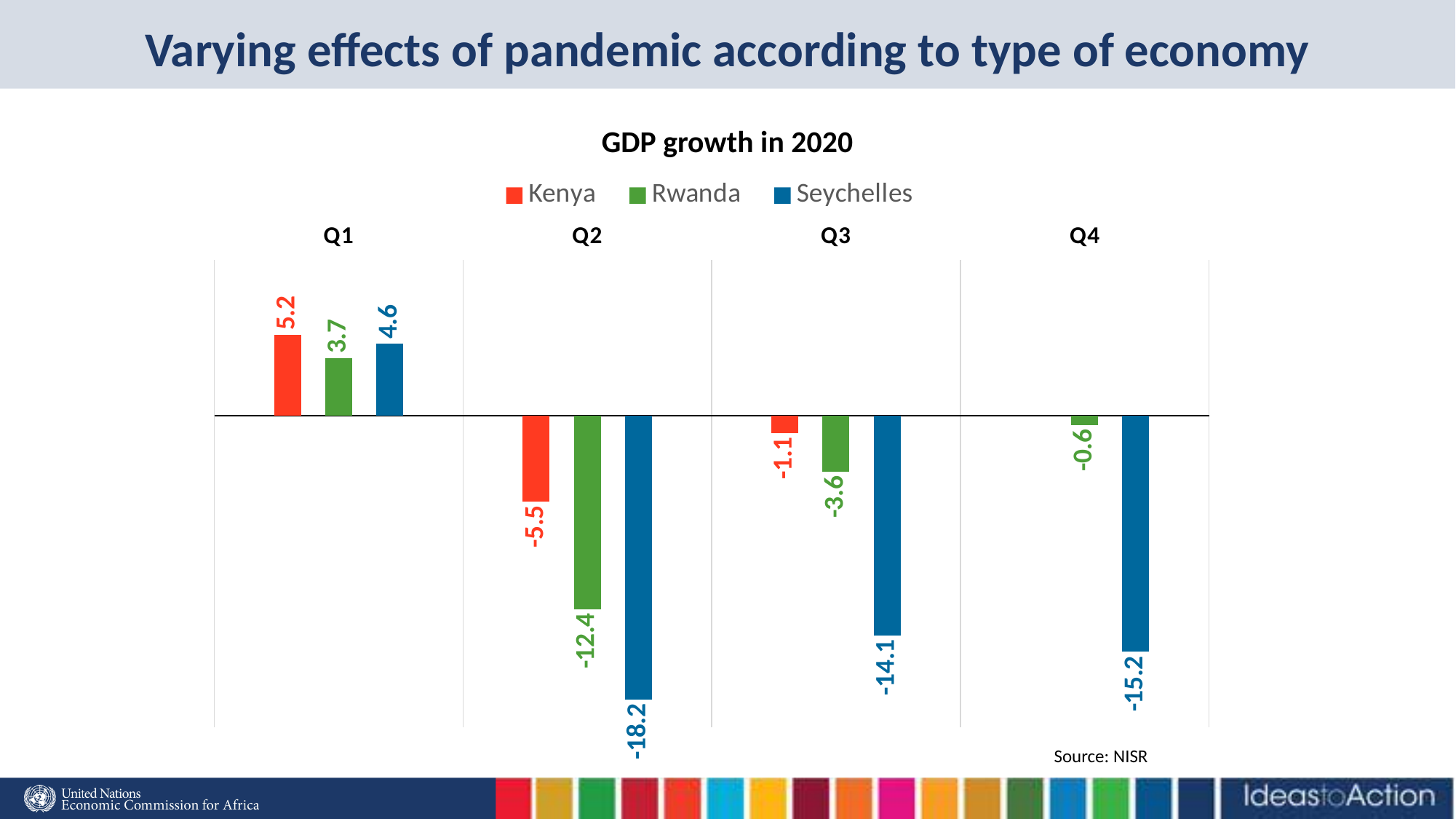
Which country has the lowest GDP growth in Q3? Seychelles What is the GDP growth value for Kenya in Q1? 5.2 What kind of chart is shown on the slide? Bar chart Which is larger, Rwanda's GDP growth in Q2 or Rwanda's GDP growth in Q3? Q3 What is the difference between Seychelles' and Kenya's GDP growth in Q2? 12.7 How many series does the legend list? 3 What is the GDP growth value for Rwanda in Q4? -0.6 How many quarters are shown on the x axis? 4 What is the GDP growth value for Seychelles in Q2? -18.2 What is the difference between Kenya's and Rwanda's GDP growth in Q1? 1.5 What is the GDP growth value for Rwanda in Q3? -3.6 Which country has the highest GDP growth in Q1? Kenya